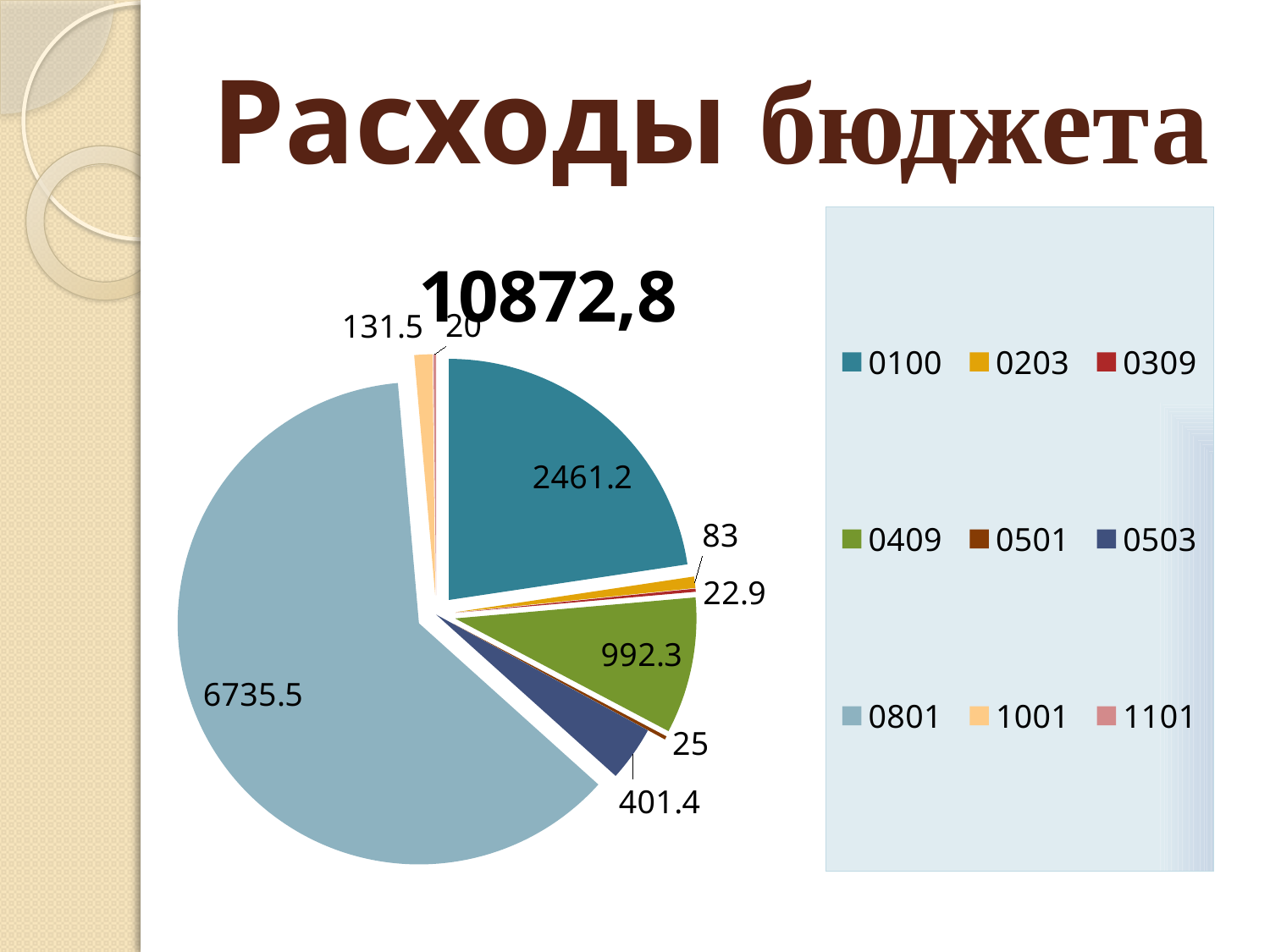
Which category has the smallest slice? 1101 What type of chart is shown on the slide? pie chart What is the value of the 0409 slice? 992.3 Which category has the largest slice? 0801 What is the value of the 0100 slice? 2461.2 What is the value of the 0801 slice? 6735.5 What total is printed above the pie chart? 10872,8 How many categories does the legend list? 9 What is the value of the 1001 slice? 131.5 What is the value of the 0503 slice? 401.4 What is the difference between the 0100 and 0409 values? 1468.9 Which is larger, the 0203 slice or the 0309 slice? 0203